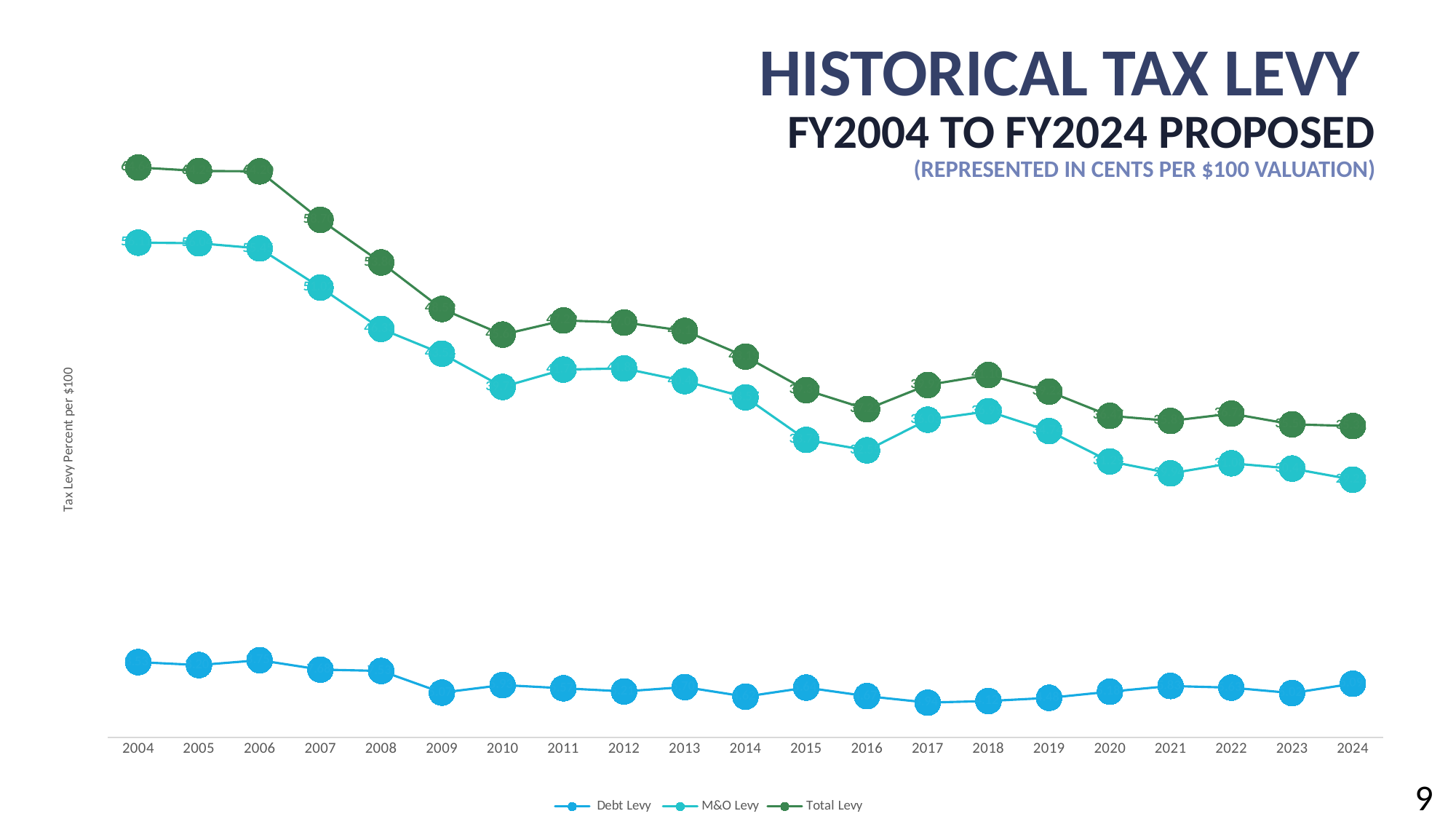
What is the label on the y axis? Tax Levy Percent per $100 Does the M&O Levy rise or fall overall from 2004 to 2024? fall In 2024, which is larger, the Debt Levy or the M&O Levy? M&O Levy Which series has the highest values across all years shown? Total Levy In 2010, which is larger, the Total Levy or the M&O Levy? Total Levy What kind of chart is shown on the slide? line chart Which series has the lowest values across all years shown? Debt Levy Does the Total Levy rise or fall overall from 2004 to 2024? fall What is the first year shown on the x axis? 2004 How many years are plotted along the x axis? 21 How many series does the legend list? 3 Which series does the legend list first? Debt Levy